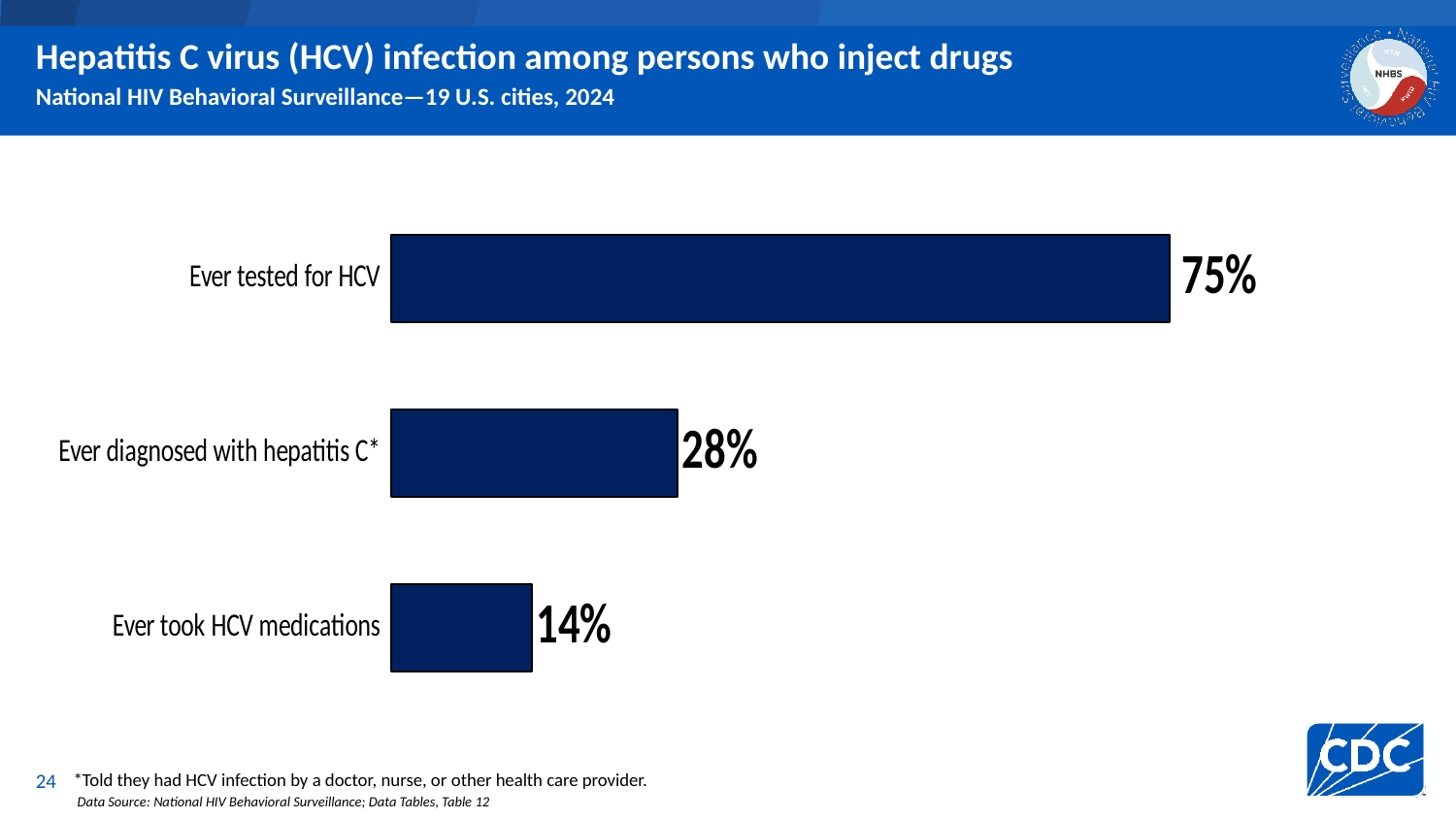
What type of chart is shown on the slide? Bar chart How many categories are shown in the chart? 3 Which is larger: the percentage ever diagnosed with hepatitis C or the percentage who ever took HCV medications? Ever diagnosed with hepatitis C What percentage of persons who inject drugs were ever diagnosed with hepatitis C? 28% What is the difference between the percentage ever diagnosed with hepatitis C and the percentage who ever took HCV medications? 14% Which category has the highest value? Ever tested for HCV What is the title of the slide? Hepatitis C virus (HCV) infection among persons who inject drugs What percentage of persons who inject drugs ever took HCV medications? 14% What is the difference between the percentage ever tested for HCV and the percentage ever diagnosed with hepatitis C? 47% Which category has the lowest value? Ever took HCV medications What colour are the bars in the chart? Dark blue What percentage of persons who inject drugs were ever tested for HCV? 75%